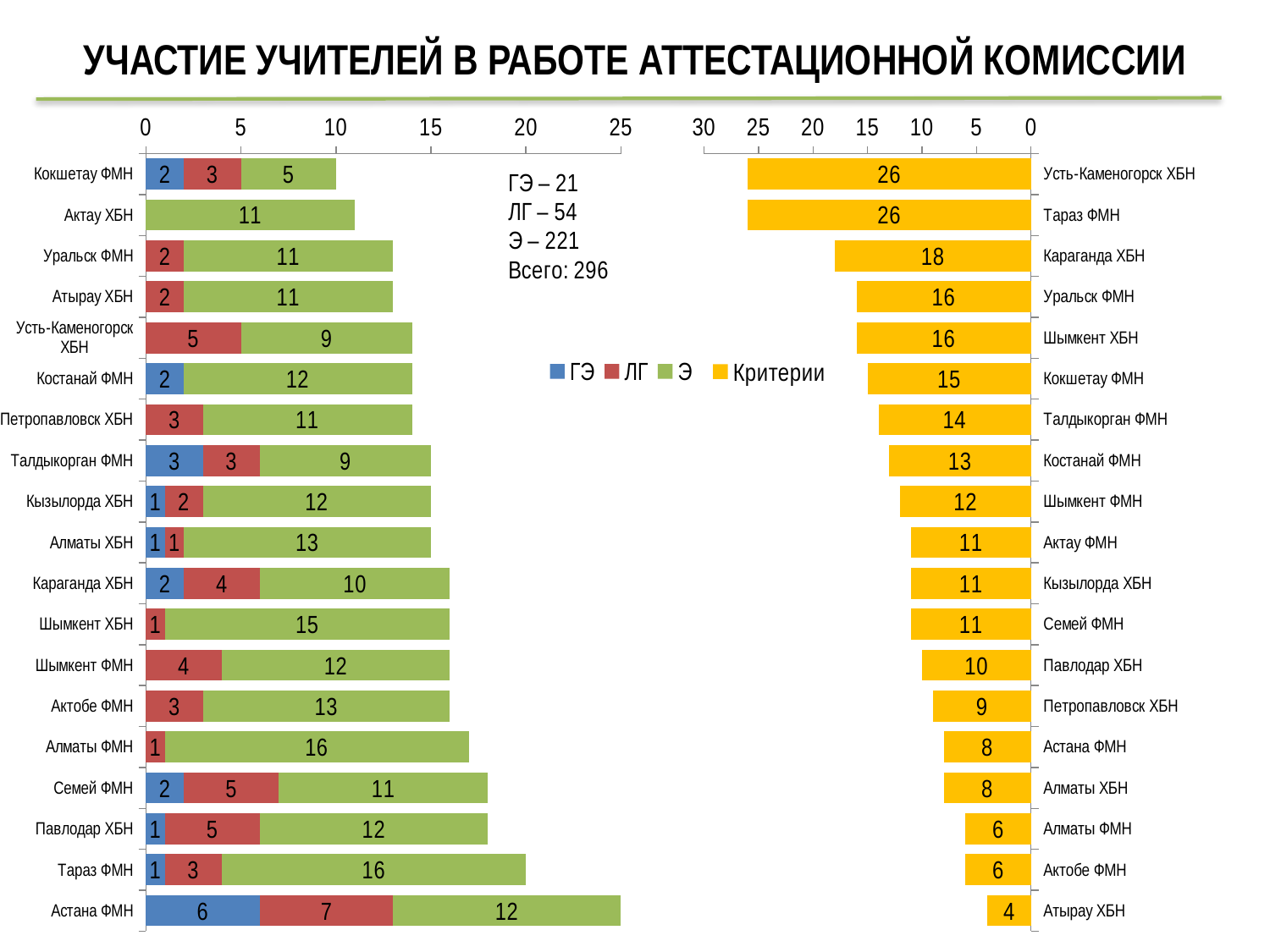
In the left stacked bar chart, what is the total of the stacked bar for Кокшетау ФМН? 10 What kind of chart is the right chart (Критерии)? Bar chart In the right chart (Критерии), how many categories are shown? 19 In the right chart (Критерии), which category has the lowest value? Атырау ХБН In the right chart (Критерии), what is the difference between the value for Тараз ФМН and the value for Атырау ХБН? 22 In the left stacked bar chart, what is the Э value for Астана ФМН? 12 In the left stacked bar chart, what is the ЛГ value for Семей ФМН? 5 In the right chart (Критерии), what is the value for Караганда ХБН? 18 In the left stacked bar chart, what is the difference between the Э value for Тараз ФМН and the Э value for Кокшетау ФМН? 11 In the left stacked bar chart, what is the total of the stacked bar for Астана ФМН? 25 In the right chart (Критерии), which is larger: the value for Костанай ФМН or the value for Павлодар ХБН? Костанай ФМН